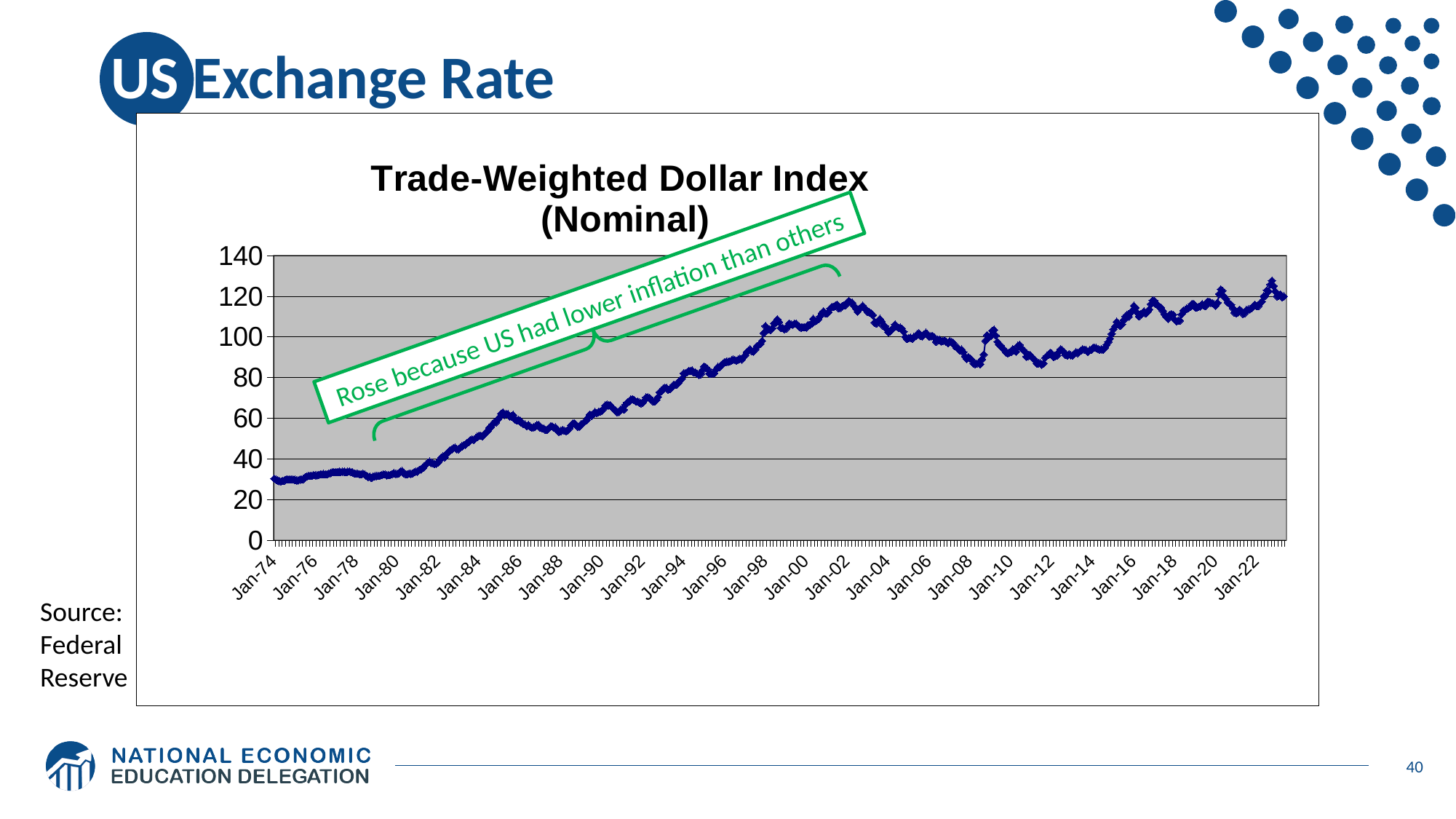
Is the value of the index at Jan-80 greater or less than 60? less Does the index rise or fall between Jan-02 and Jan-08? fall What is the title of the chart? Trade-Weighted Dollar Index (Nominal) Is the value of the index at Jan-22 greater or less than 100? greater What kind of chart is shown on the slide? line chart Is the peak of the index around Jan-02 higher or lower than the peak around Jan-22? lower Is the value of the index at Jan-02 greater or less than 100? greater Does the index rise or fall between Jan-74 and Jan-86? rise How many labelled tick marks are there on the x axis? 25 What does the green annotation on the chart say? Rose because US had lower inflation than others